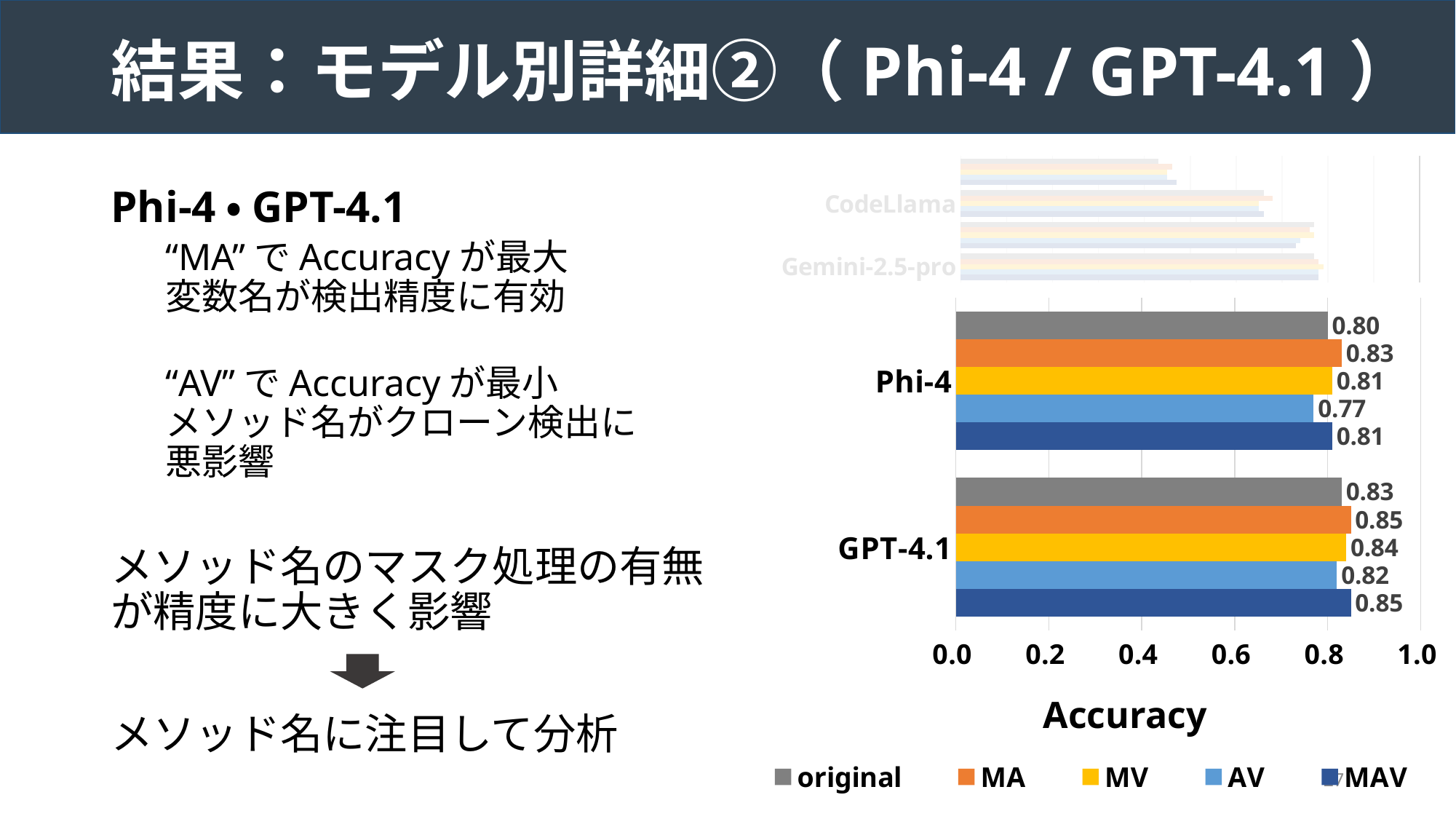
What is the Accuracy of GPT-4.1 for the AV series? 0.82 Which series has the lowest Accuracy for Phi-4? AV Which is larger: the AV Accuracy for Phi-4 or the AV Accuracy for GPT-4.1? GPT-4.1 Which series has the highest Accuracy for Phi-4? MA What is the Accuracy of GPT-4.1 for the MV series? 0.84 What is the Accuracy of Phi-4 for the original series? 0.80 What is the Accuracy of Phi-4 for the MA series? 0.83 What is the difference between the MA and AV Accuracy values for Phi-4? 0.06 What is the difference between the original Accuracy of GPT-4.1 and the original Accuracy of Phi-4? 0.03 What kind of chart is shown on the slide? Bar chart How many series does the legend list? 5 What is the label of the horizontal axis of the chart? Accuracy